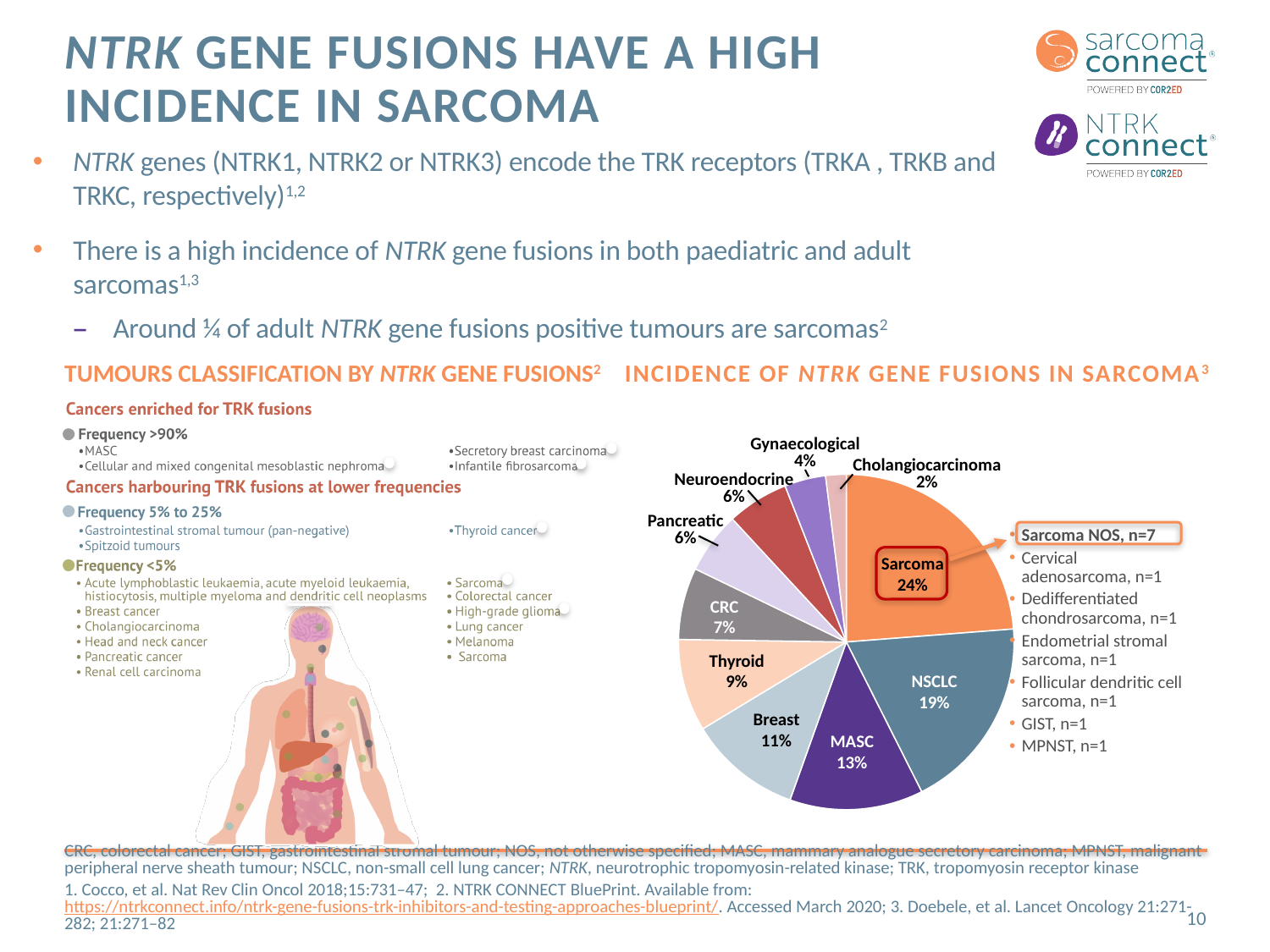
Which category has the smallest slice in the pie chart? Cholangiocarcinoma In the pie chart, what percentage is shown for Sarcoma? 24% Which category has the largest slice in the pie chart? Sarcoma In the pie chart, what percentage is shown for Cholangiocarcinoma? 2% According to the callout next to the pie chart, how many cases are Sarcoma NOS? n=7 In the pie chart, what is the combined percentage of Pancreatic and Neuroendocrine? 12% In the pie chart, what is the difference in percentage points between Sarcoma and NSCLC? 5 In the pie chart, which is larger: Breast or Thyroid? Breast How many categories (slices) are shown in the pie chart? 10 In the pie chart, what percentage is shown for NSCLC? 19% In the pie chart, what percentage is shown for MASC? 13% What kind of chart is shown on the right side of the slide under 'Incidence of NTRK gene fusions in sarcoma'? Pie chart